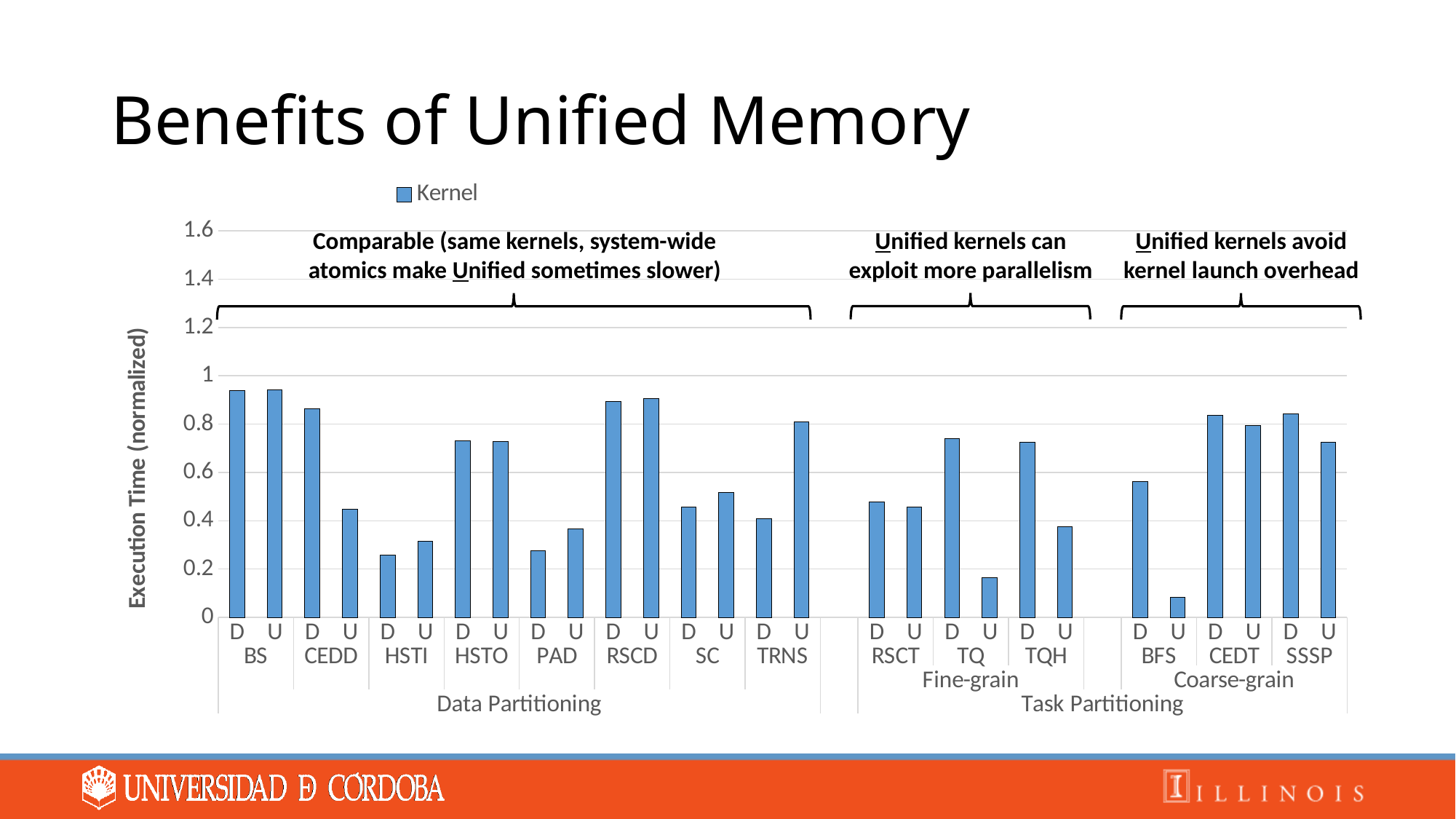
Is the value for the U bar of TQ greater or less than 0.2? less Is the value for the D bar of HSTI greater or less than 0.4? less How many series does the legend list? 1 For TQH, which is larger, the D bar or the U bar? D Is the value for the U bar of BFS greater or less than 0.2? less What is the name of the series shown in the legend? Kernel What kind of chart is shown on the slide? bar chart How many benchmarks (named categories such as BS, CEDD, HSTI) are shown on the x axis? 14 What is the label of the vertical axis? Execution Time (normalized) For TRNS, which is larger, the D bar or the U bar? U Which bar is the lowest in the chart? BFS U